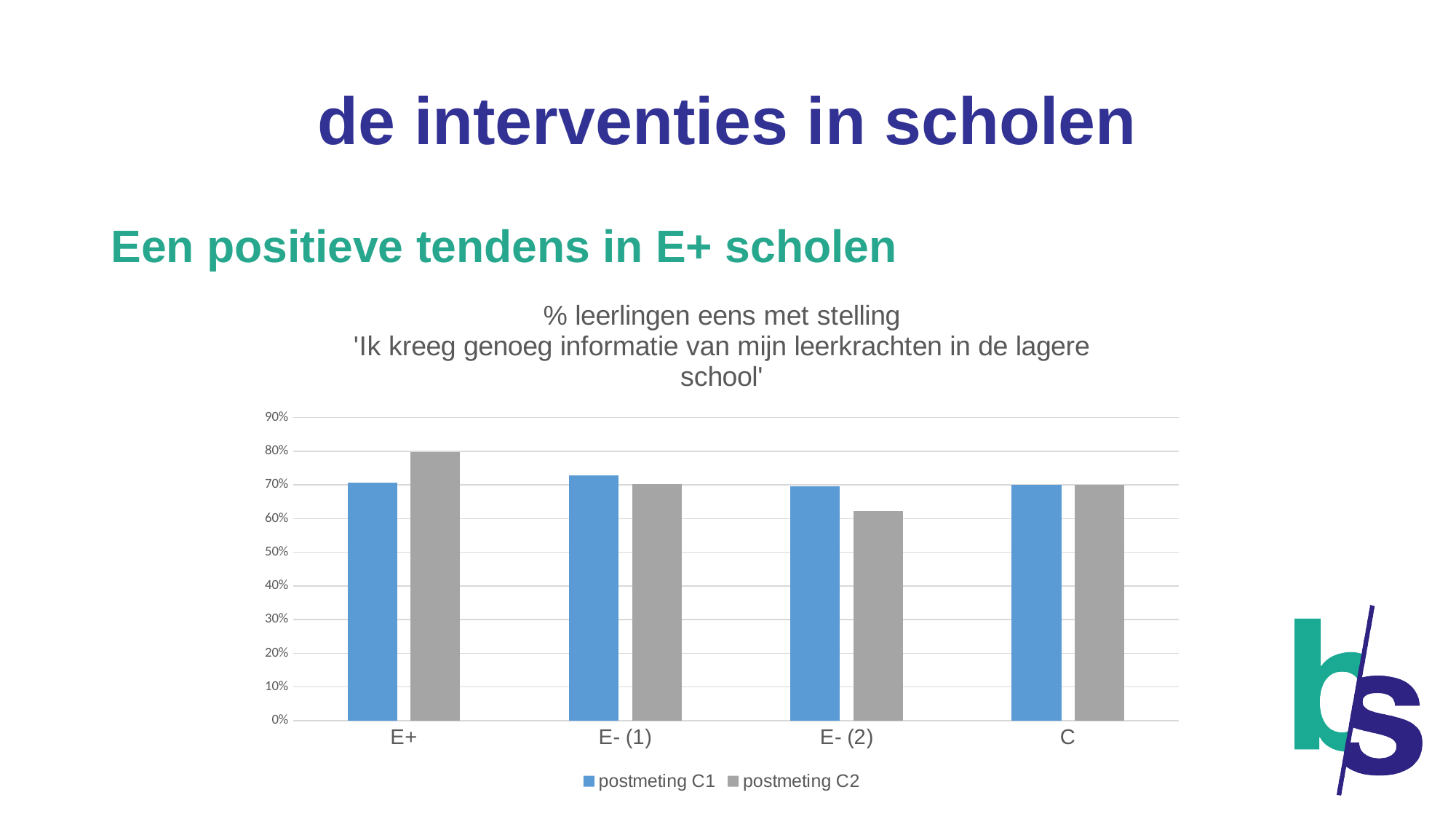
What are the two series named in the chart's legend? postmeting C1 and postmeting C2 For E+, which is larger: postmeting C1 or postmeting C2? postmeting C2 Is the postmeting C2 value for E+ greater or less than 70%? greater How many categories are shown on the x axis of the chart? 4 How many series does the chart's legend list? 2 Is the postmeting C1 value for E- (1) greater or less than 60%? greater What kind of chart is shown on the slide? bar chart Which category has the lowest value for postmeting C2? E- (2) Which category has the highest value for postmeting C2? E+ For E- (2), which is larger: postmeting C1 or postmeting C2? postmeting C1 Which colour represents postmeting C2 in the chart? grey Is the postmeting C2 value for E- (2) greater or less than 70%? less